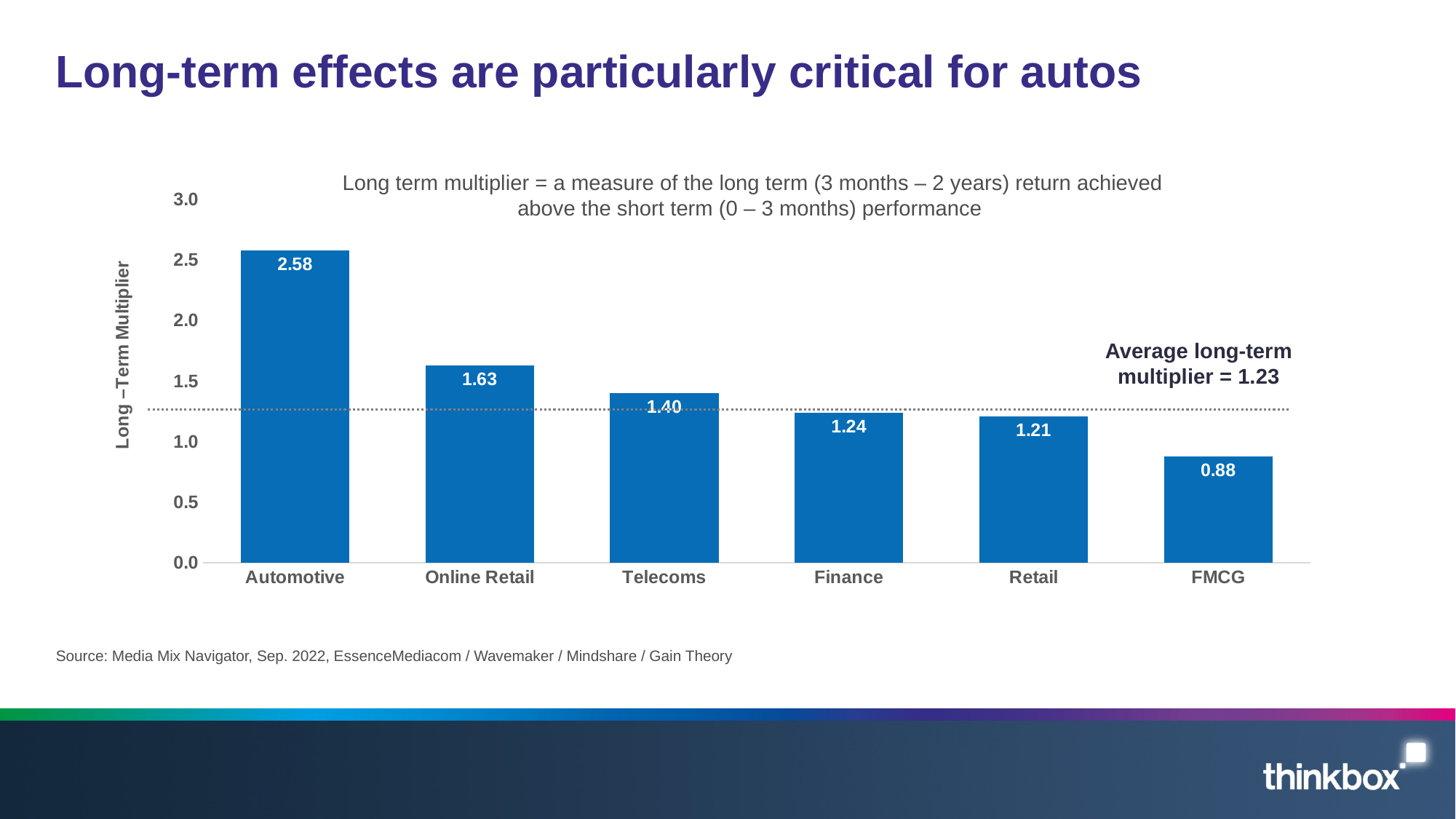
Which has a larger long-term multiplier, Telecoms or Retail? Telecoms How many categories are shown on the chart? 6 What is the difference between the long-term multipliers for Automotive and Online Retail? 0.95 Which category has the lowest long-term multiplier? FMCG What is the long-term multiplier for FMCG? 0.88 What is the long-term multiplier for Automotive? 2.58 Which category has the highest long-term multiplier? Automotive What kind of chart is shown on the slide? Bar chart Is the value for Finance greater or less than 1.0? greater What is the average long-term multiplier indicated by the dotted line? 1.23 What is the difference between the long-term multipliers for Telecoms and FMCG? 0.52 What is the long-term multiplier for Online Retail? 1.63